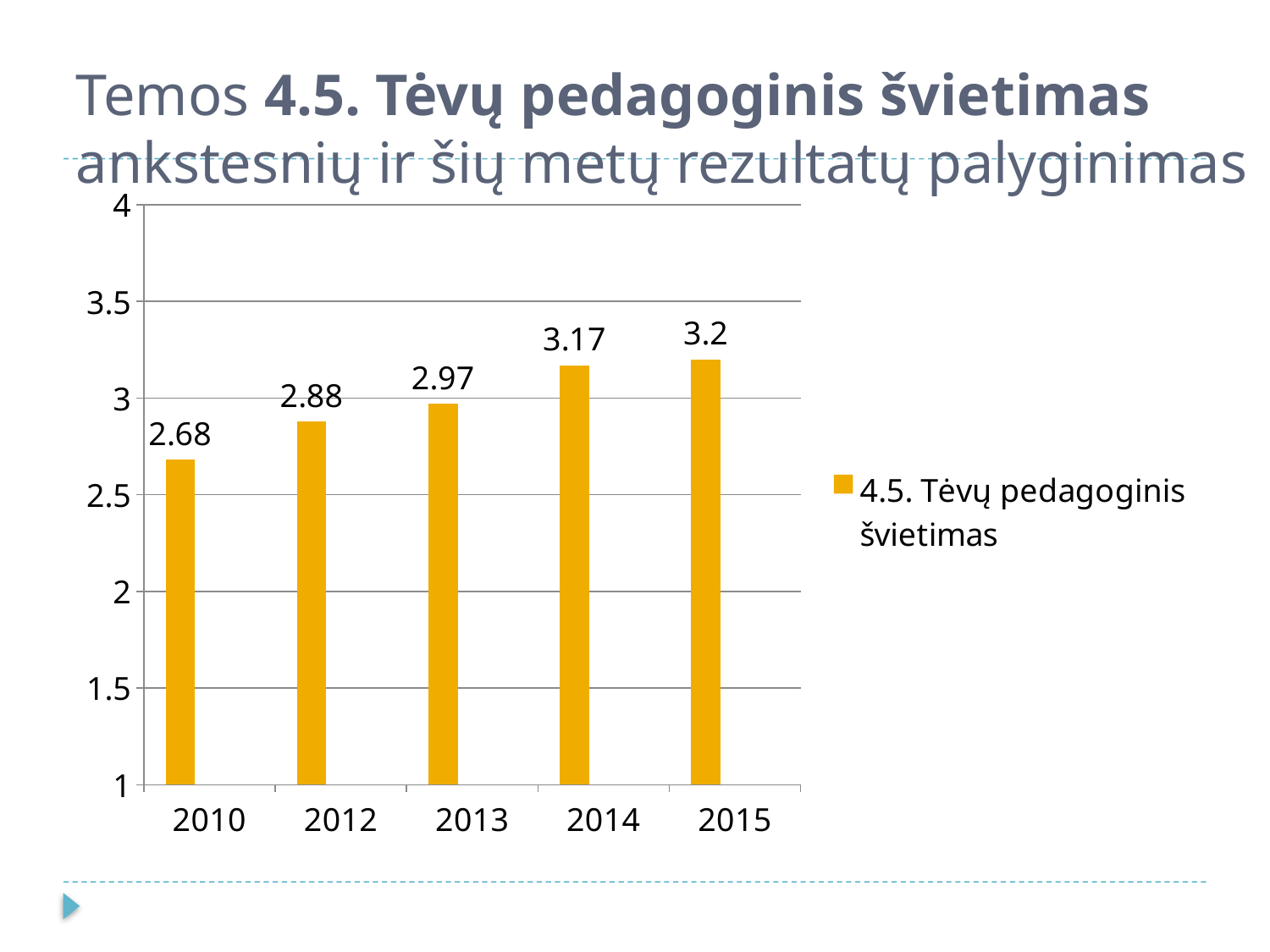
Which is larger, the value for 2012 or the value for 2013? 2013 How many series does the legend list? 1 What is the value for 2015? 3.2 What is the difference between the values for 2014 and 2012? 0.29 Which year has the lowest value? 2010 What is the value for 2010? 2.68 What is the value for 2013? 2.97 What kind of chart is shown? bar chart Do the values rise or fall from 2010 to 2015? rise How many years are shown on the x axis? 5 Is the value for 2014 greater or less than 3? greater Which year has the highest value? 2015